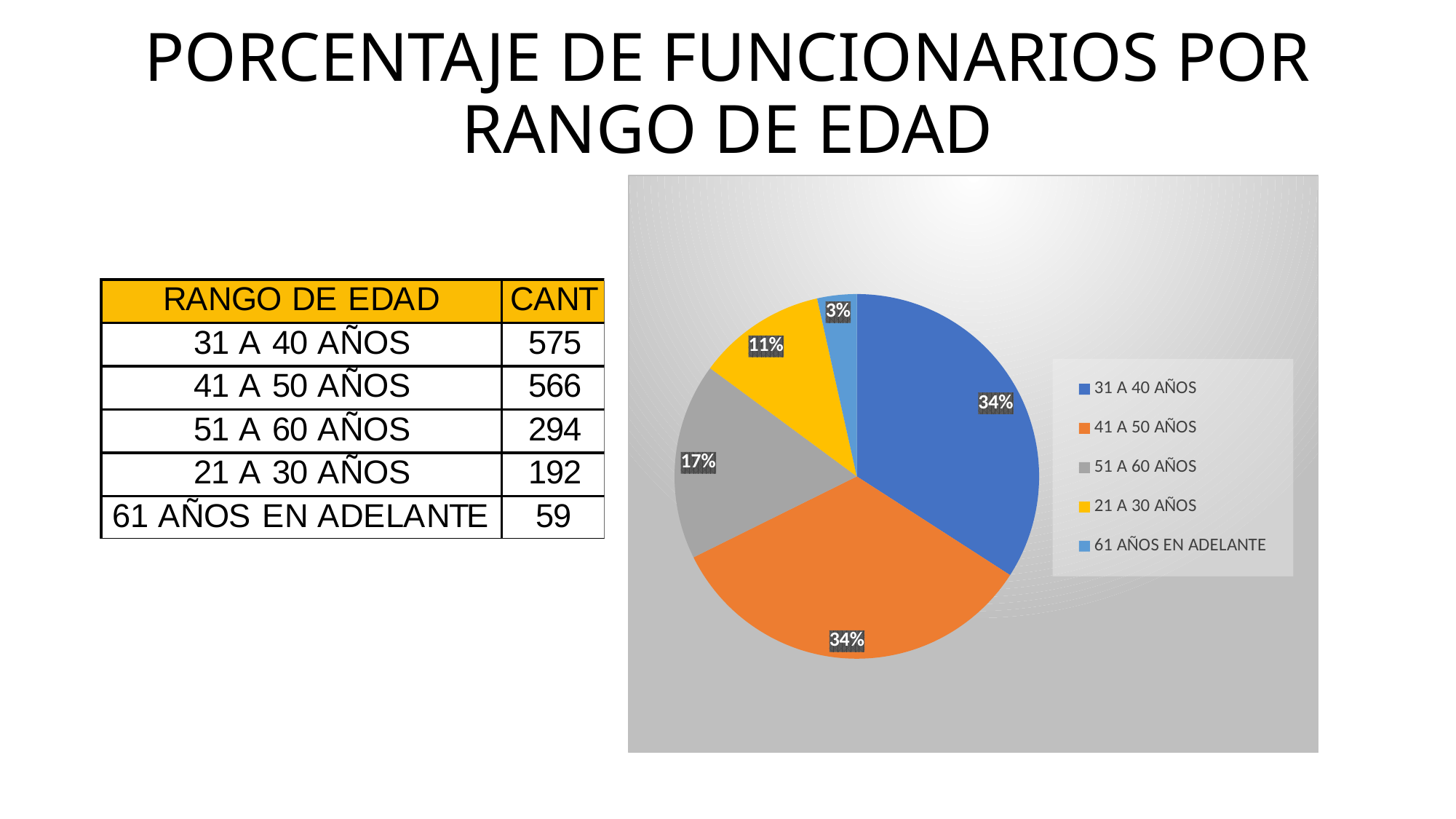
What percentage is shown for the 31 A 40 AÑOS slice in the pie chart? 34% What percentage is shown for the 61 AÑOS EN ADELANTE slice in the pie chart? 3% How many slices does the pie chart have? 5 What colour is the 21 A 30 AÑOS slice in the pie chart? yellow What kind of chart is shown on the slide? pie chart Which slice is larger in the pie chart, 51 A 60 AÑOS or 21 A 30 AÑOS? 51 A 60 AÑOS How many entries does the pie chart's legend list? 5 Which age range has the smallest slice in the pie chart? 61 AÑOS EN ADELANTE By how many percentage points does the 51 A 60 AÑOS slice exceed the 21 A 30 AÑOS slice in the pie chart? 6 percentage points What percentage is shown for the 41 A 50 AÑOS slice in the pie chart? 34%